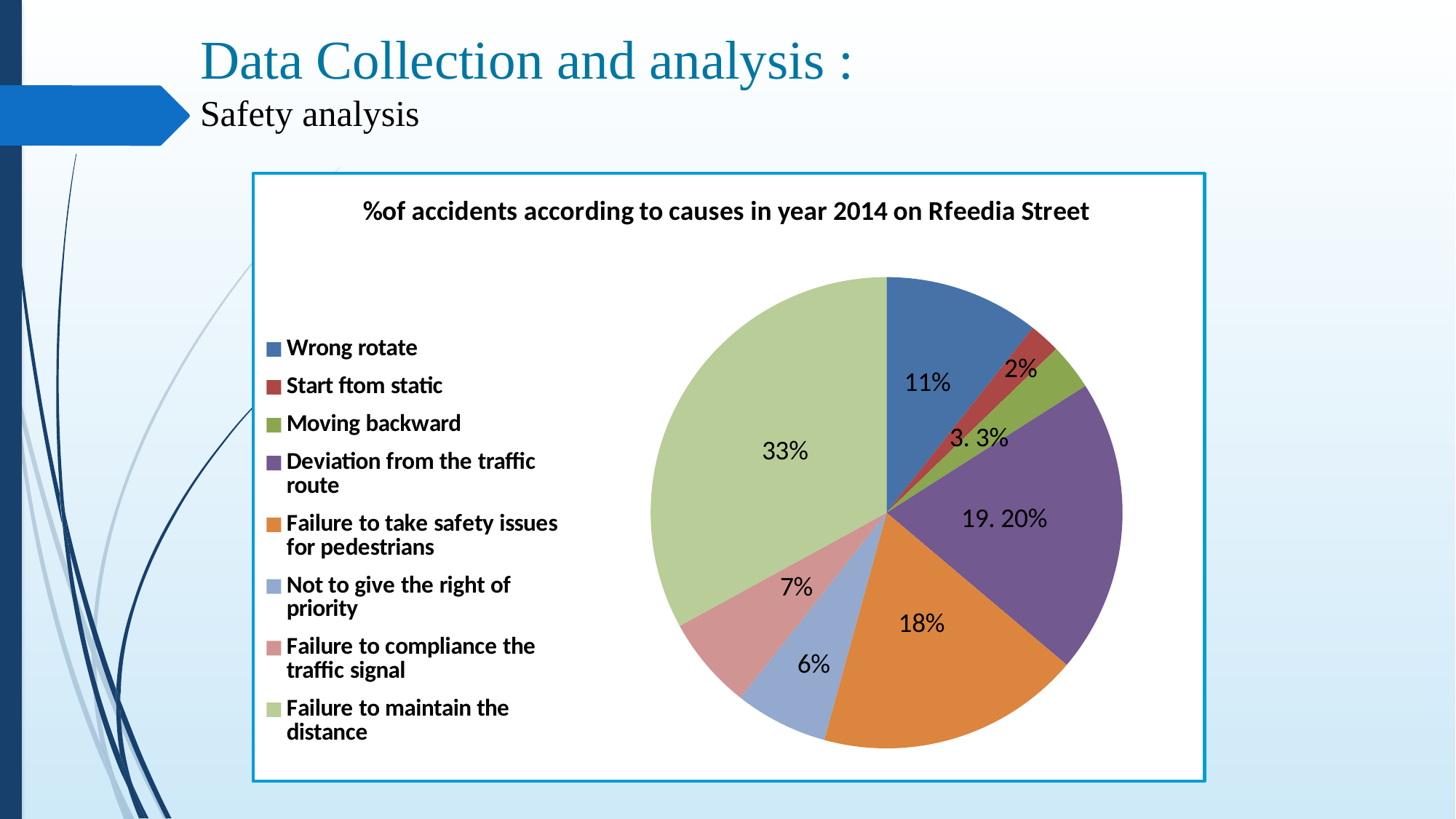
How many causes are listed in the legend of the pie chart? 8 What percentage of accidents is attributed to Wrong rotate? 11% What percentage of accidents is attributed to Not to give the right of priority? 6% Which cause accounts for the largest share of accidents? Failure to maintain the distance Which has the larger share: Wrong rotate or Not to give the right of priority? Wrong rotate How many percentage points larger is the share for Failure to maintain the distance than the share for Failure to take safety issues for pedestrians? 15 percentage points What percentage of accidents is attributed to Failure to maintain the distance? 33% Which cause accounts for the smallest share of accidents? Start ftom static What percentage of accidents is attributed to Start ftom static? 2% What percentage of accidents is attributed to Failure to take safety issues for pedestrians? 18% What percentage of accidents is attributed to Failure to compliance the traffic signal? 7% What kind of chart is shown on the slide? pie chart